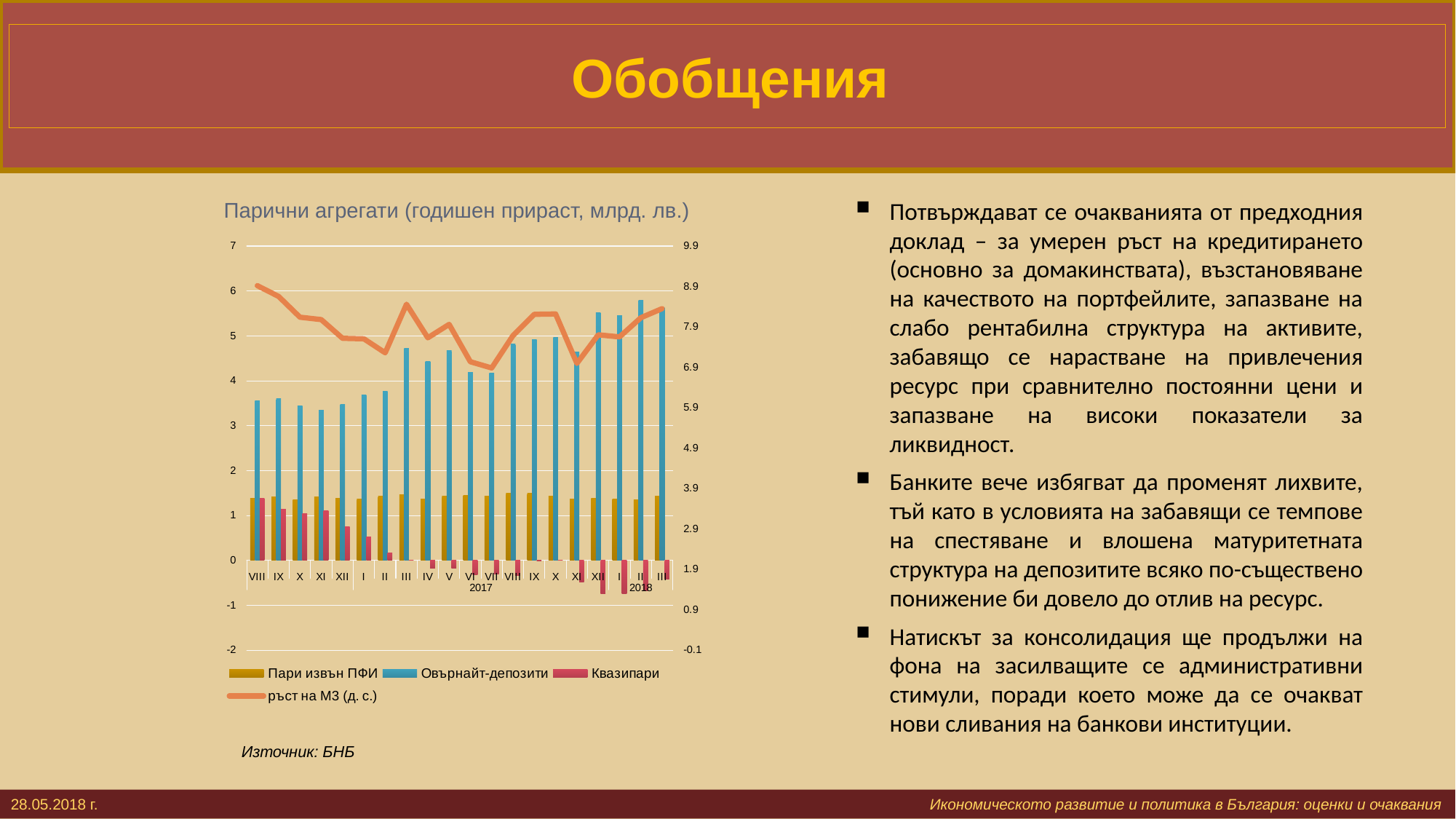
What source is cited below the chart? БНБ What is the title of the chart? Парични агрегати (годишен прираст, млрд. лв.) What kind of chart is shown on the slide? A combined bar and line chart Is the value of Овърнайт-депозити for the first month (VIII) greater or less than 3? greater How many monthly categories are plotted along the x axis? 20 Is the value of Пари извън ПФИ for III 2018 greater or less than 1? greater Do the values of Квазипари rise or fall along the x axis from VIII 2016 to III 2018? fall In which month does Овърнайт-депозити reach its highest value? II 2018 Which is larger for III 2018: Овърнайт-депозити or Пари извън ПФИ? Овърнайт-депозити Is the value of Квазипари for XII 2017 greater or less than 0? less How many series does the chart legend list? 4